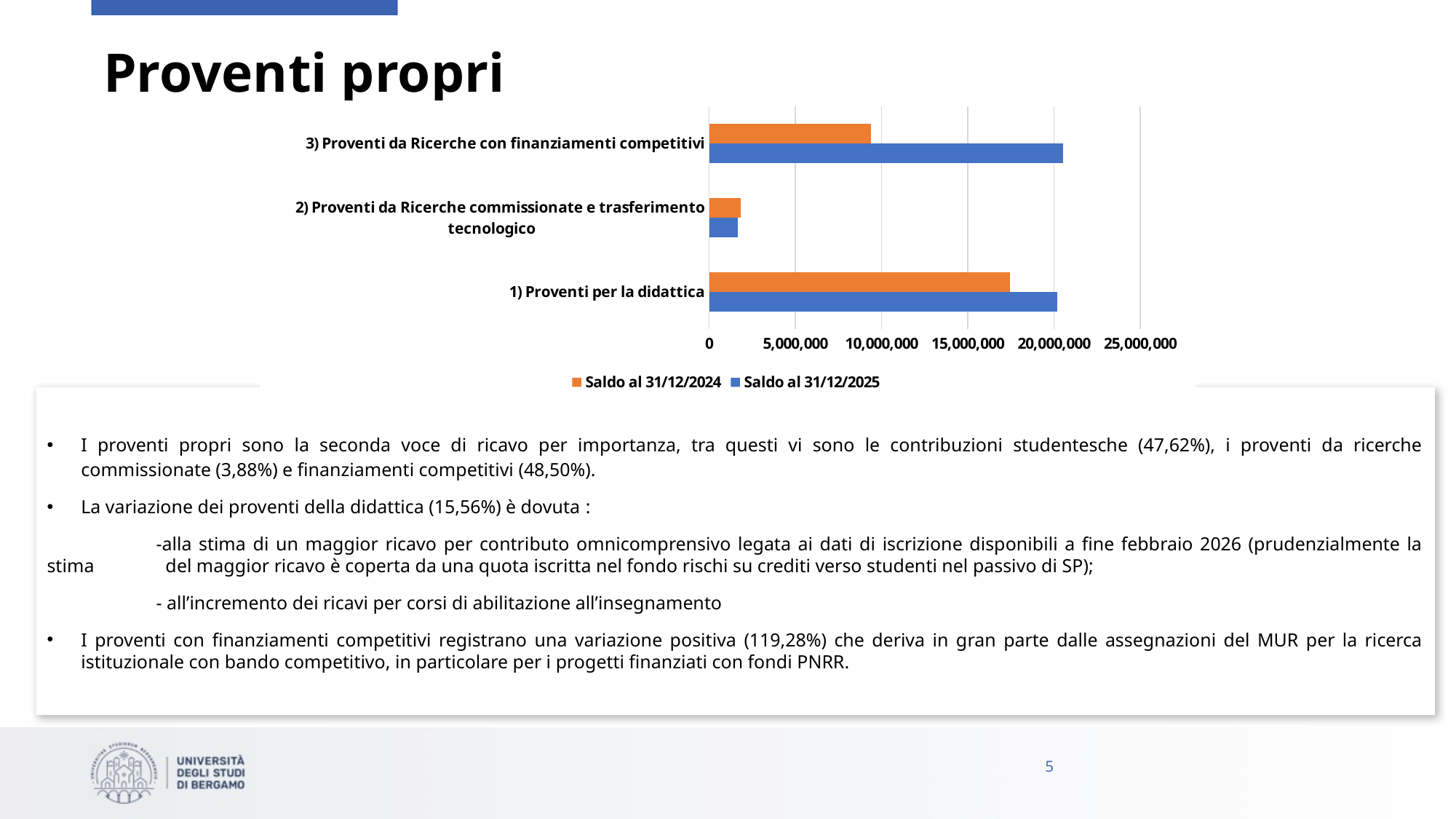
Which category has the lowest value for Saldo al 31/12/2024? 2) Proventi da Ricerche commissionate e trasferimento tecnologico Is the Saldo al 31/12/2024 value for 2) Proventi da Ricerche commissionate e trasferimento tecnologico greater or less than 5,000,000? less Which series is shown in orange in the chart? Saldo al 31/12/2024 Which series is shown in blue in the chart? Saldo al 31/12/2025 Which category has the highest value for Saldo al 31/12/2024? 1) Proventi per la didattica How many series does the chart legend list? 2 What kind of chart is shown on the slide? bar chart For 3) Proventi da Ricerche con finanziamenti competitivi, which is larger: Saldo al 31/12/2024 or Saldo al 31/12/2025? Saldo al 31/12/2025 For 1) Proventi per la didattica, which is larger: Saldo al 31/12/2024 or Saldo al 31/12/2025? Saldo al 31/12/2025 Which category has the lowest value for Saldo al 31/12/2025? 2) Proventi da Ricerche commissionate e trasferimento tecnologico How many categories are plotted in the chart? 3 Is the Saldo al 31/12/2025 value for 3) Proventi da Ricerche con finanziamenti competitivi greater or less than 15,000,000? greater